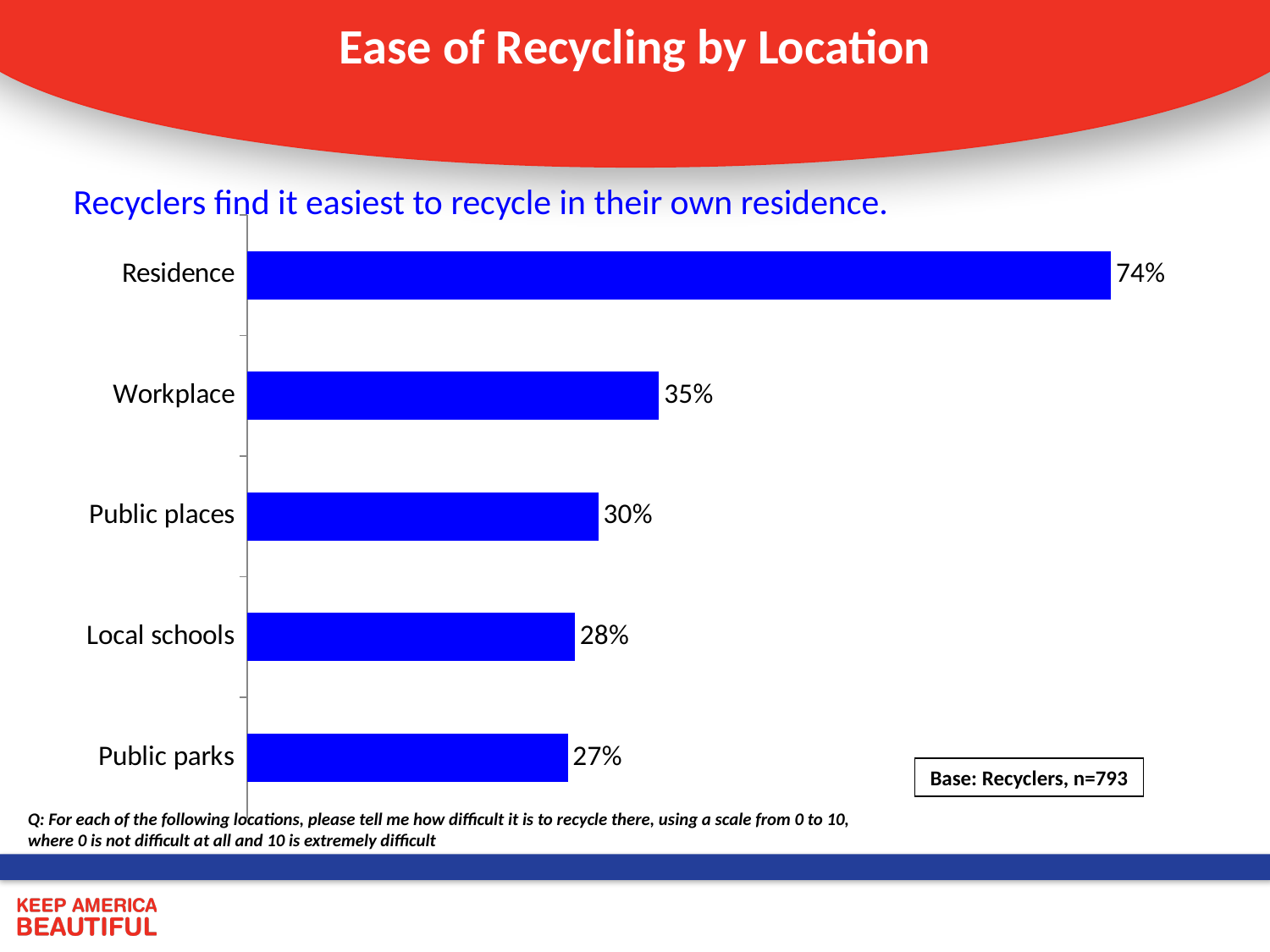
What is the value for Residence? 74% What is the value for Public places? 30% Which location has the highest value? Residence What is the value for Local schools? 28% What is the title of the slide? Ease of Recycling by Location What is the difference between the values for Residence and Workplace? 39% What is the value for Public parks? 27% What kind of chart is shown on the slide? Bar chart How many locations are shown in the chart? 5 Which location has the lowest value? Public parks What is the value for Workplace? 35% Which is larger, the value for Workplace or the value for Public places? Workplace